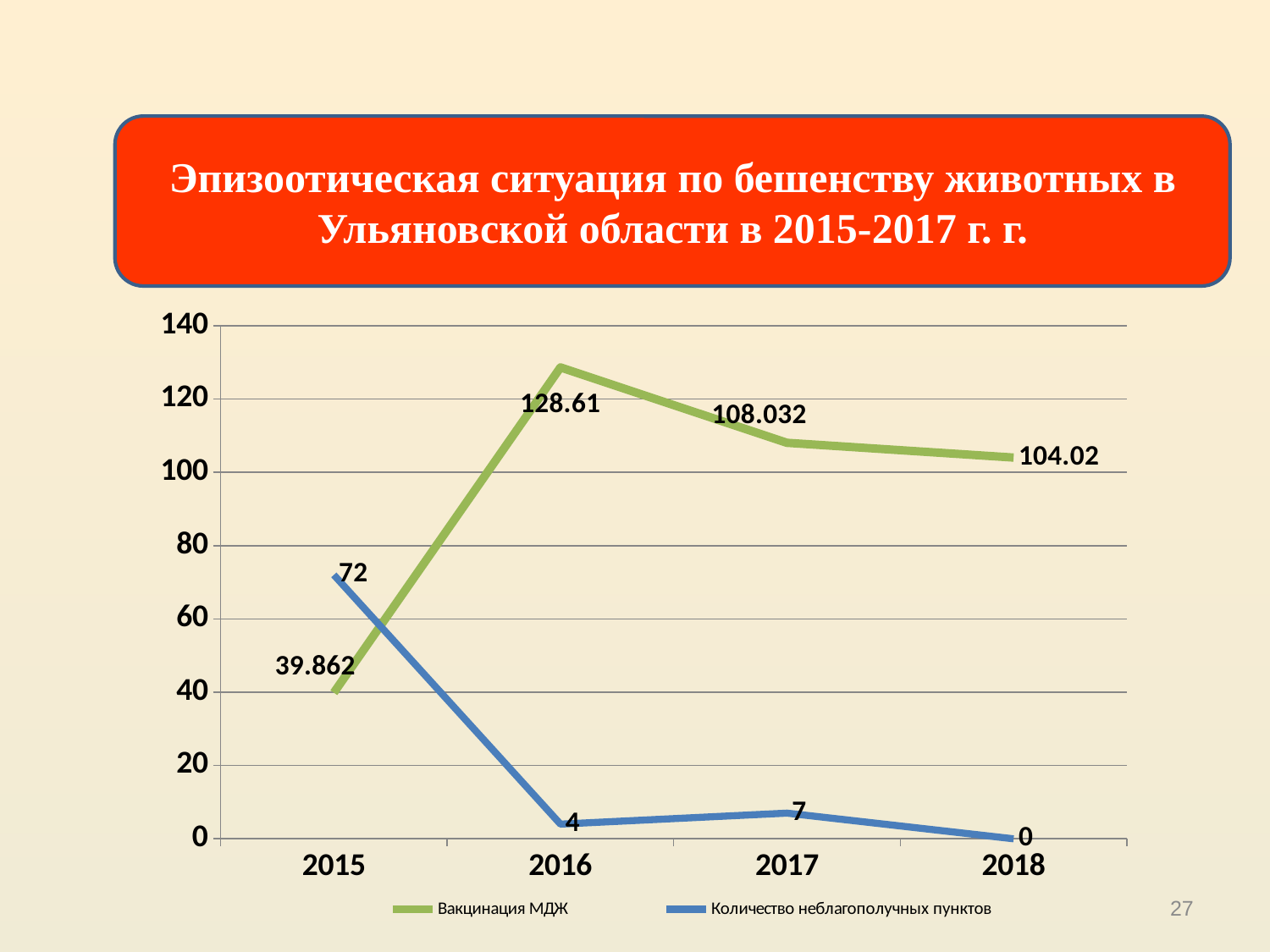
How many years are shown on the x axis? 4 How many series does the legend list? 2 What is the value of Количество неблагополучных пунктов in 2015? 72 Which is larger in 2015: Вакцинация МДЖ or Количество неблагополучных пунктов? Количество неблагополучных пунктов What is the value of Количество неблагополучных пунктов in 2017? 7 In which year is Вакцинация МДЖ highest? 2016 What type of chart is shown on the slide? line chart What is the value of Вакцинация МДЖ in 2018? 104.02 What is the difference between Количество неблагополучных пунктов in 2015 and in 2016? 68 Does Количество неблагополучных пунктов rise or fall from 2015 to 2016? fall In which year is Количество неблагополучных пунктов lowest? 2018 What is the value of Вакцинация МДЖ in 2016? 128.61